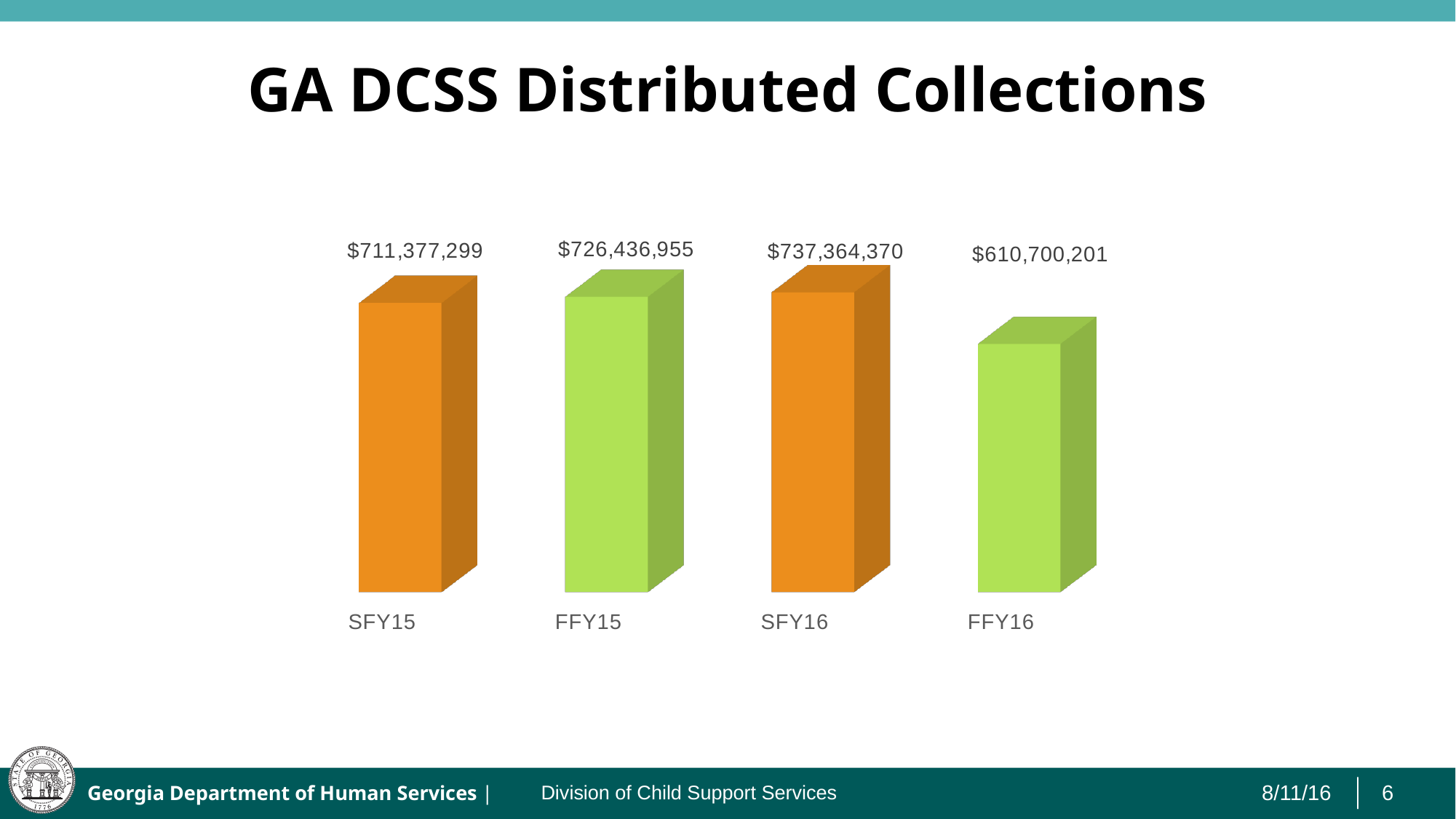
Which is larger, the value for SFY16 or the value for FFY16? SFY16 What is the value for FFY16? $610,700,201 What is the value for SFY16? $737,364,370 What is the value for FFY15? $726,436,955 What is the difference between the FFY15 and FFY16 values? $115,736,754 What is the value for SFY15? $711,377,299 What kind of chart is shown on the slide? Bar chart Which category has the lowest distributed collections? FFY16 Which category has the highest distributed collections? SFY16 How many categories are shown in the chart? 4 What is the title of the chart? GA DCSS Distributed Collections What is the difference between the SFY16 and SFY15 values? $25,987,071